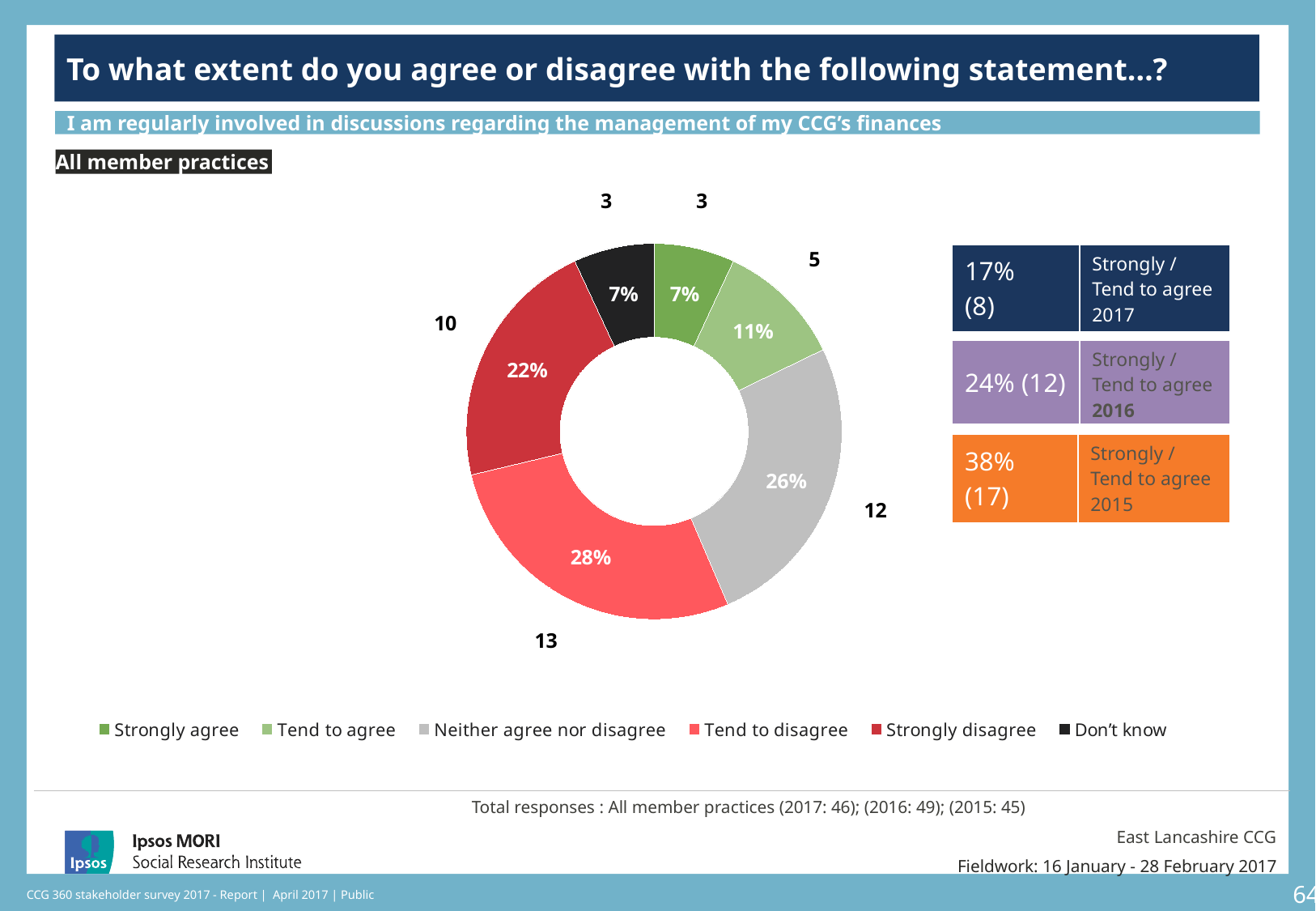
What percentage of respondents said 'Neither agree nor disagree'? 26% Which response category has the largest share of the doughnut chart? Tend to disagree What colour represents 'Don't know' in the chart? Black What type of chart is shown on the slide? Doughnut chart What percentage of respondents said 'Tend to disagree'? 28% How many respondents (count) said 'Strongly disagree'? 10 How many response categories does the legend list? 6 What is the difference in percentage points between 'Tend to disagree' and 'Strongly disagree'? 6 What percentage of respondents said 'Tend to agree'? 11% What is the combined percentage for 'Strongly agree' and 'Tend to agree' in 2017, as shown in the box to the right of the chart? 17% Which is larger: the share for 'Neither agree nor disagree' or the share for 'Strongly disagree'? Neither agree nor disagree What was the 'Strongly / Tend to agree' percentage in 2015? 38%